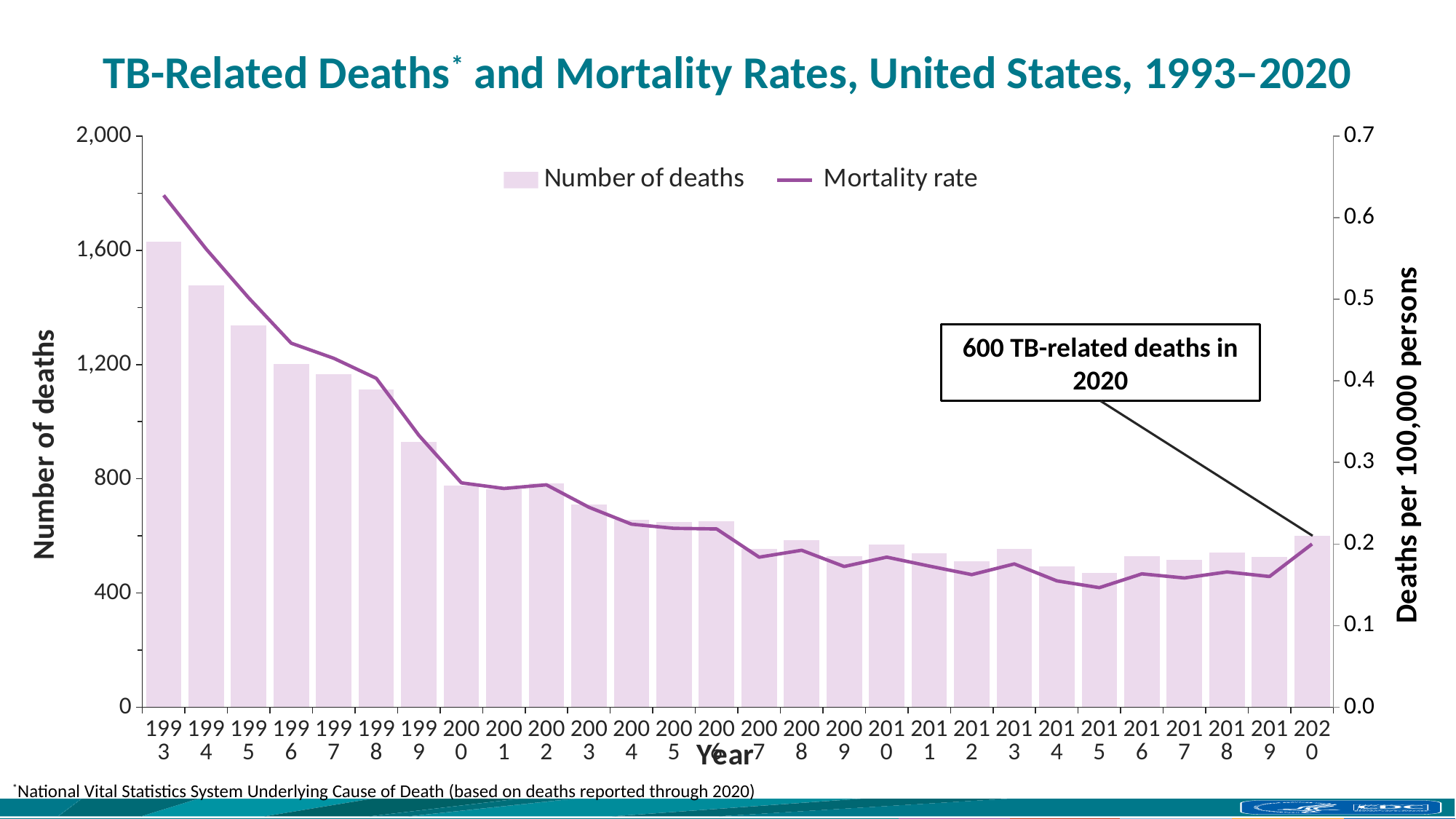
How many series does the chart's legend list? 2 According to the callout on the chart, how many TB-related deaths were there in 2020? 600 What kind of chart is shown on the slide? A bar chart combined with a line chart Does the number of deaths generally rise or fall from 1993 to 2020? Fall Which year had more deaths, 1994 or 1995? 1994 How many years are shown along the x axis of the chart? 28 Which year has the highest mortality rate? 1993 Is the mortality rate in 2020 greater or less than 0.3? less Which year has the highest number of deaths? 1993 Is the mortality rate in 1993 greater or less than 0.6? greater What is the title of the right-hand vertical axis? Deaths per 100,000 persons Is the number of deaths in 1993 greater or less than 1,200? greater